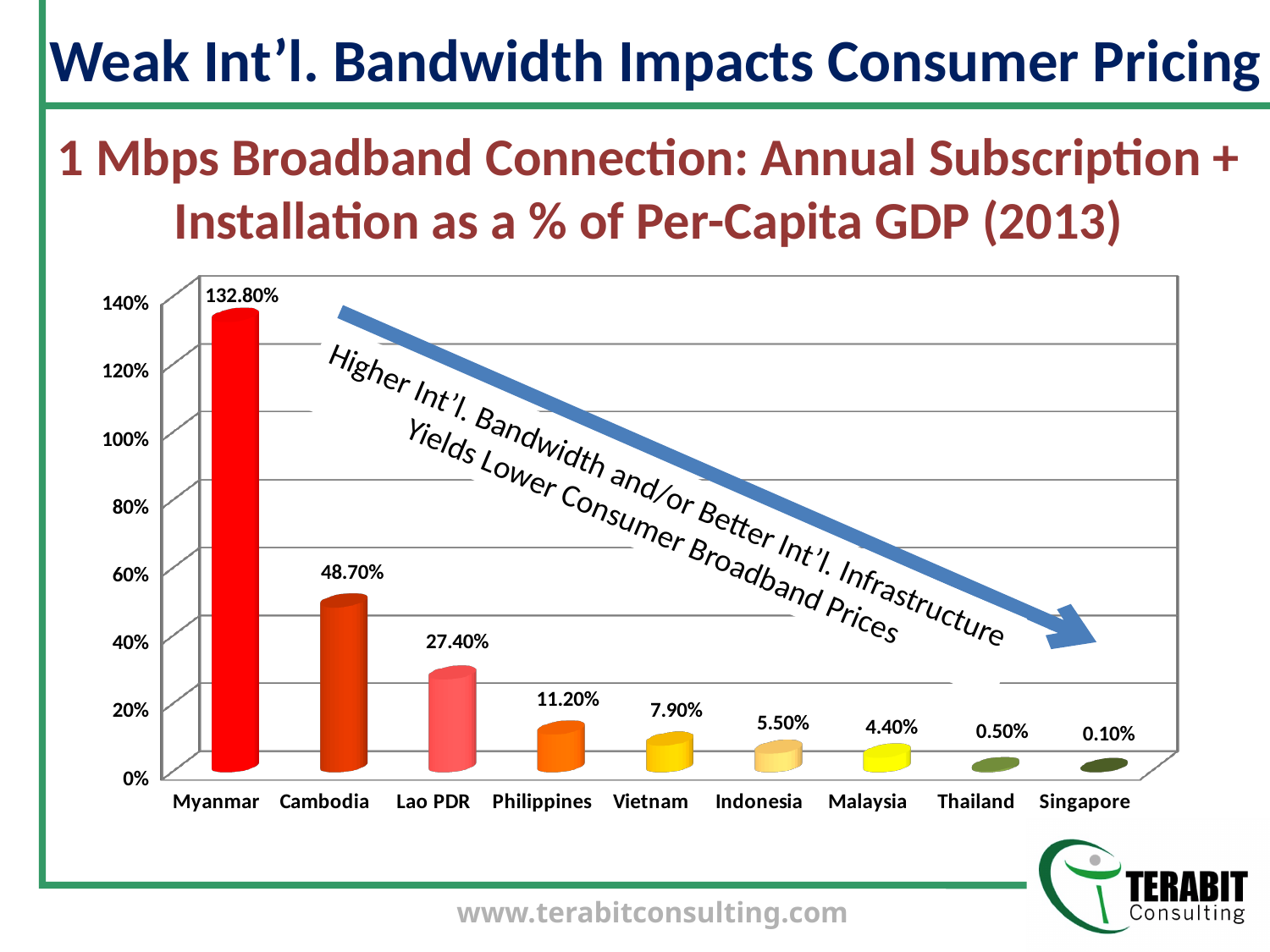
What is the value for Singapore? 0.10% Which country has the lowest value? Singapore How many countries are shown in the chart? 9 What is the value for Myanmar? 132.80% What kind of chart is shown on the slide? Bar chart What is the difference between the values for Cambodia and Lao PDR? 21.30% What is the value for Cambodia? 48.70% Is the value for Lao PDR greater or less than 20%? greater What is the value for Vietnam? 7.90% Which is larger, the value for Philippines or the value for Indonesia? Philippines Do the values rise or fall from left to right along the x axis? Fall Which country has the highest value? Myanmar